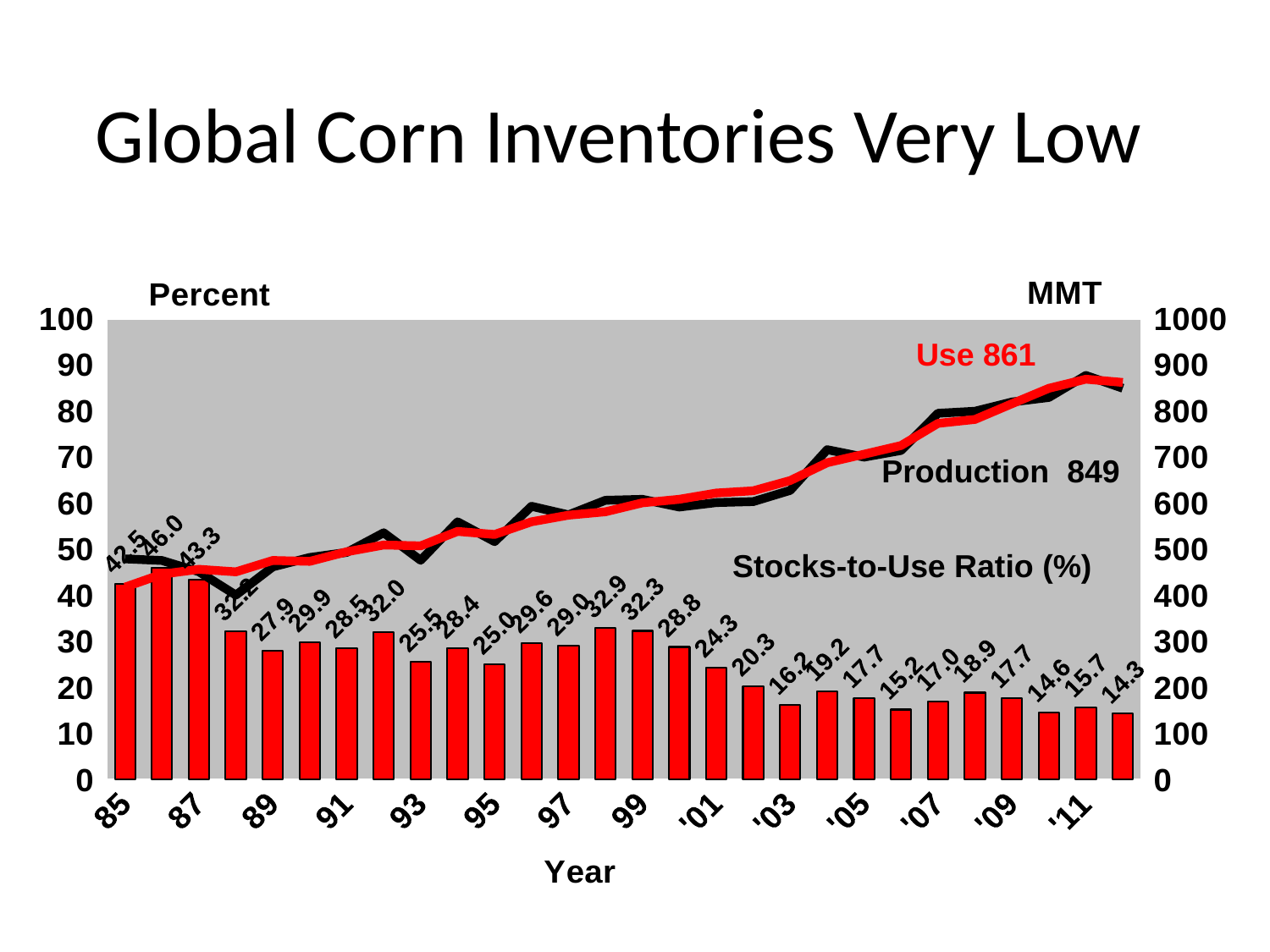
What is the stocks-to-use ratio shown for '12, the last bar? 14.3 What is the highest stocks-to-use ratio value shown? 46.0 What value is labelled for Production at the end of the black line? 849 What is the difference between the labelled Use (861) and Production (849) values? 12 Which is larger at the end of the series, Use or Production? Use What value is labelled for Use at the end of the red line? 861 Is the Production value for '07 greater or less than 700 MMT? greater Does the stocks-to-use ratio generally rise or fall from '85 to '12? fall How many bars (years) are plotted for the stocks-to-use ratio? 28 Which year has the highest stocks-to-use ratio? '86 What is the stocks-to-use ratio shown for '85? 42.5 What is the label on the x axis of the chart? Year